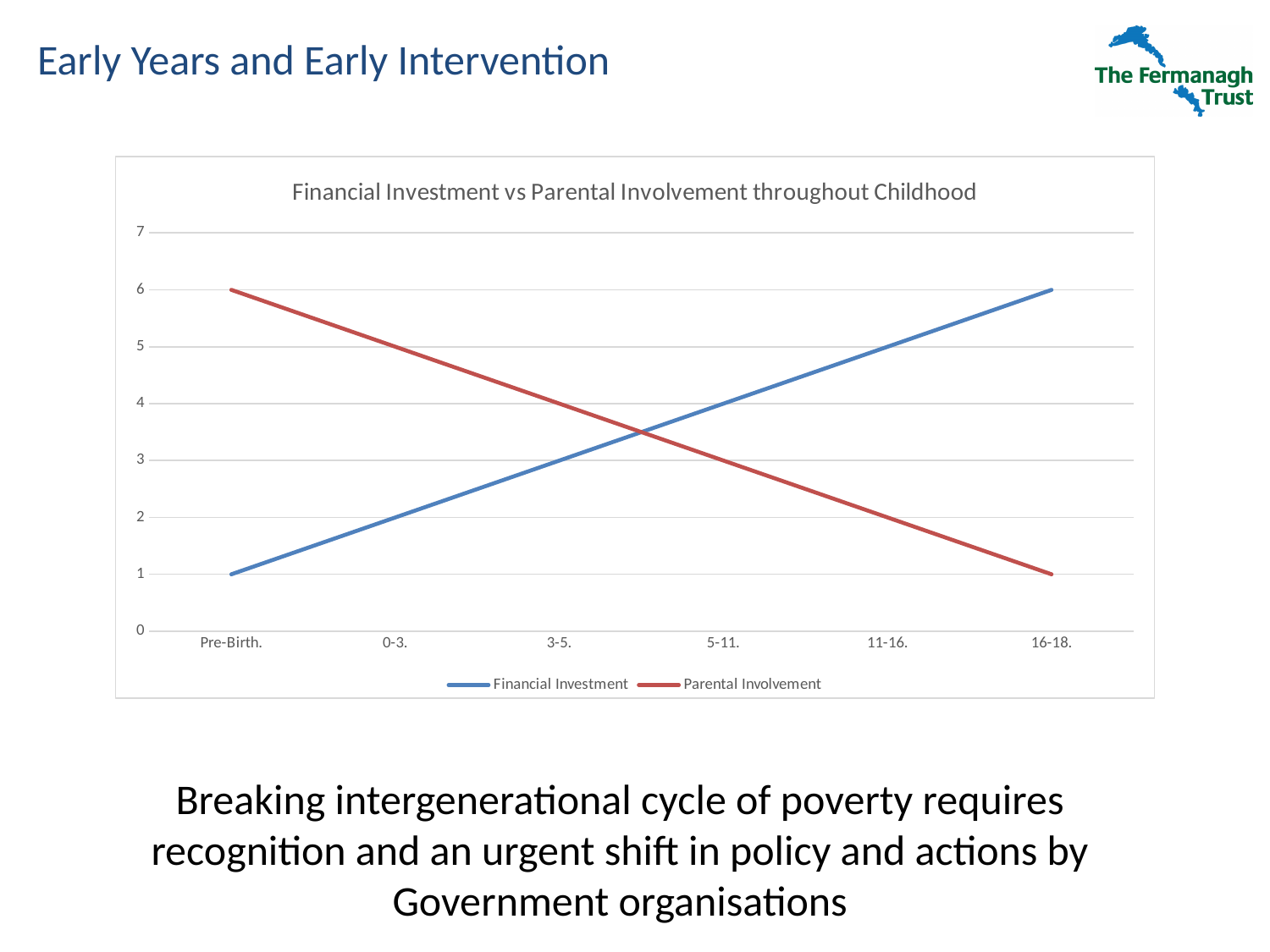
What is the value of Financial Investment at Pre-Birth? 1 What is the value of Parental Involvement at Pre-Birth? 6 Does Parental Involvement rise or fall from Pre-Birth to 16-18? fall Does Financial Investment rise or fall from Pre-Birth to 16-18? rise How many age categories are shown on the x axis? 6 What is the title of the chart? Financial Investment vs Parental Involvement throughout Childhood At Pre-Birth, which series has the higher value, Financial Investment or Parental Involvement? Parental Involvement At 16-18, what is the difference between Financial Investment and Parental Involvement? 5 What kind of chart is shown on the slide? line chart What is the value of Parental Involvement at 16-18? 1 How many series does the legend list? 2 What is the value of Financial Investment at 16-18? 6